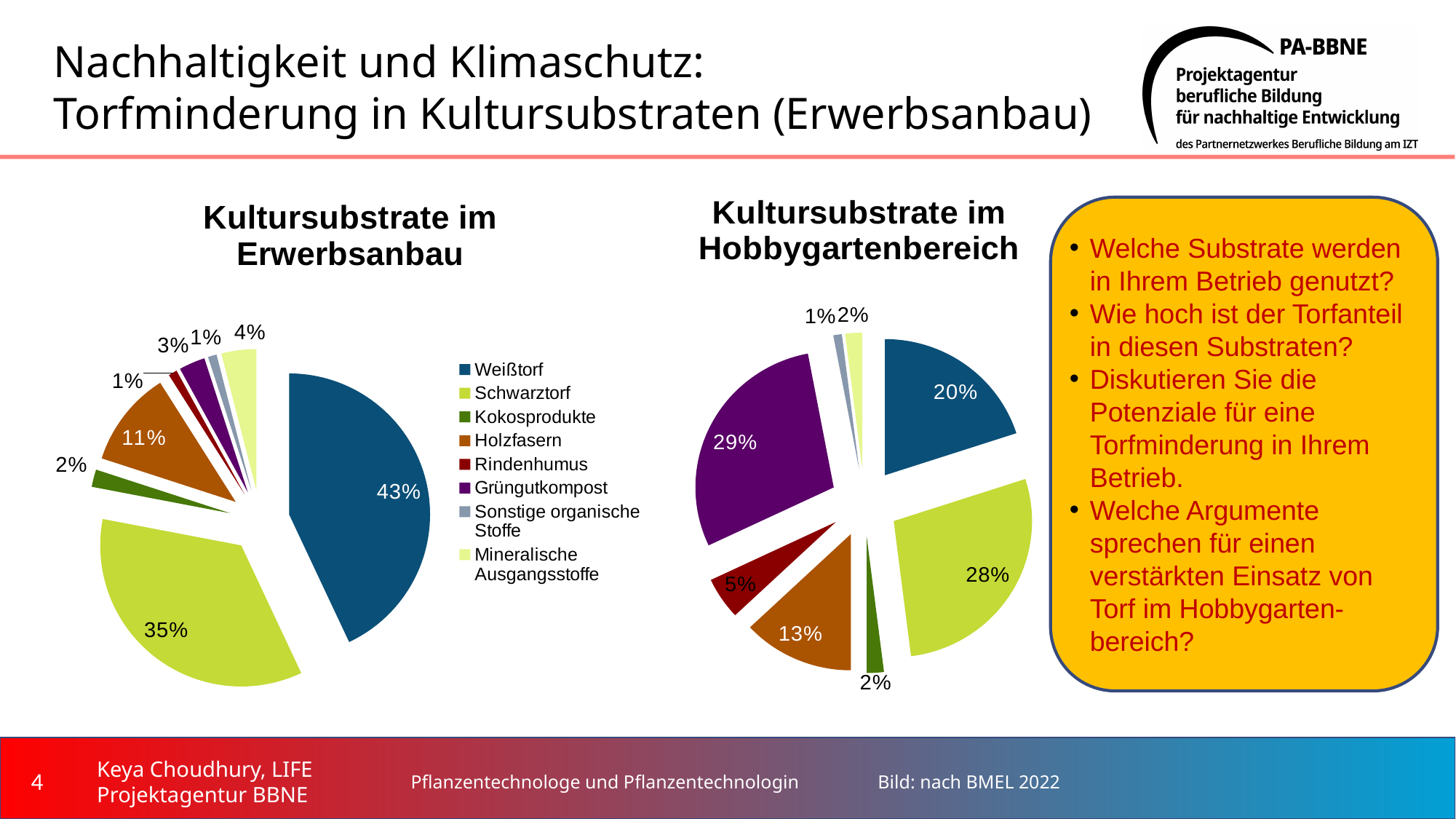
What type of chart is 'Kultursubstrate im Hobbygartenbereich'? Pie chart In the chart 'Kultursubstrate im Erwerbsanbau', what share does Weißtorf have? 43% In the chart 'Kultursubstrate im Erwerbsanbau', what is the difference between the shares of Weißtorf and Schwarztorf? 8 percentage points In the chart 'Kultursubstrate im Hobbygartenbereich', what share does the Weißtorf (dark blue) slice have? 20% Which colour represents Grüngutkompost in the legend of the chart 'Kultursubstrate im Erwerbsanbau'? Purple In the chart 'Kultursubstrate im Hobbygartenbereich', what is the largest share shown? 29% In the chart 'Kultursubstrate im Erwerbsanbau', which category has the largest share? Weißtorf How many entries does the legend of the chart 'Kultursubstrate im Erwerbsanbau' list? 8 In the chart 'Kultursubstrate im Erwerbsanbau', what share does Holzfasern have? 11% In the chart 'Kultursubstrate im Hobbygartenbereich', which is larger: the Schwarztorf slice or the Weißtorf slice? Schwarztorf In the chart 'Kultursubstrate im Hobbygartenbereich', what share does the Holzfasern (brown) slice have? 13% In the chart 'Kultursubstrate im Erwerbsanbau', which is larger: Holzfasern or Mineralische Ausgangsstoffe? Holzfasern